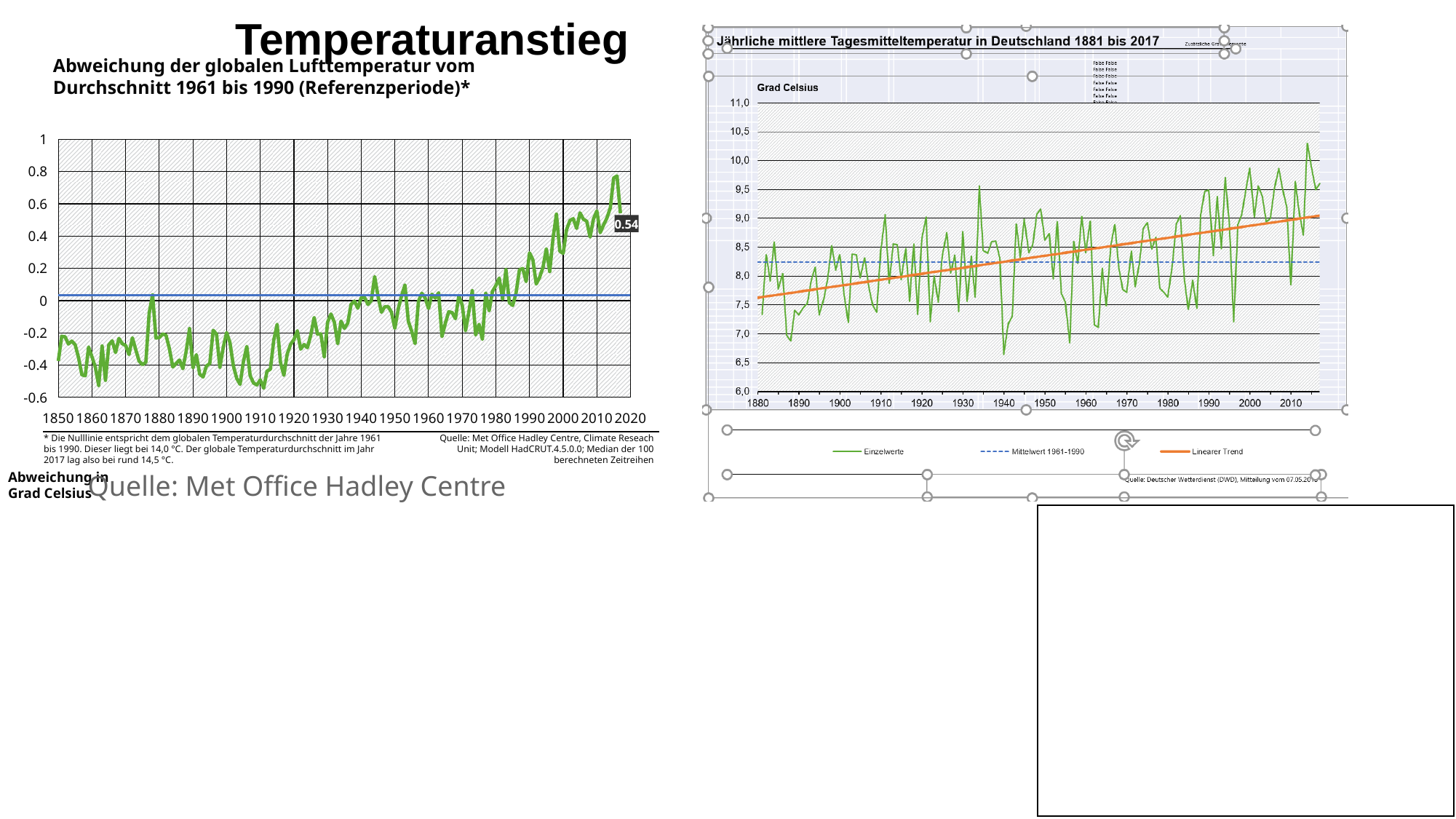
What kind of chart is the left chart, 'Abweichung der globalen Lufttemperatur vom Durchschnitt 1961 bis 1990'? line chart In the right chart, does the 'Linearer Trend' line rise or fall from 1880 to 2017? rise In the left chart, is the value for 2000 greater or less than 0? greater In the left chart, is the value for 1910 greater or less than 0? less In the right chart, is the 'Linearer Trend' value for 1880 greater or less than 8,0? less In the left chart, what is the first year shown on the x axis? 1850 In the left chart, what value is printed as the data label at the end of the line? 0.54 In the right chart, which series is drawn as an orange line? Linearer Trend What kind of chart is the right chart, 'Jährliche mittlere Tagesmitteltemperatur in Deutschland 1881 bis 2017'? line chart In the left chart, do the values generally rise or fall from 1850 to 2020? rise How many series does the legend of the right chart, 'Jährliche mittlere Tagesmitteltemperatur in Deutschland 1881 bis 2017', list? 3